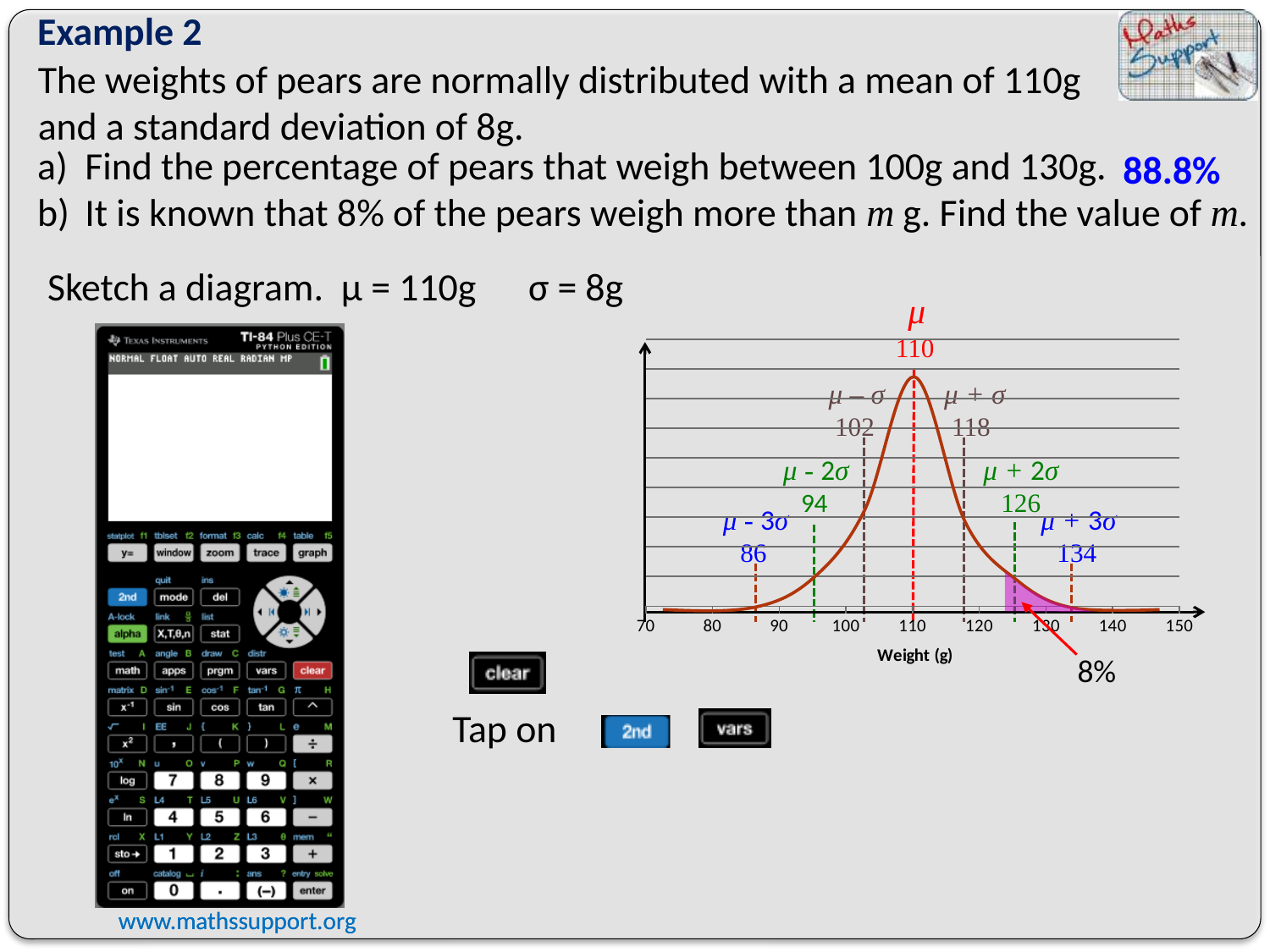
What value is marked at μ + σ on the chart? 118 What percentage is labelled for the shaded region in the right tail of the curve? 8% What value is marked at μ + 3σ on the chart? 134 What is the difference between the values marked at μ + σ and μ − σ? 16 What value is marked at μ on the chart? 110 What is the label on the horizontal axis of the chart? Weight (g) What value is marked at μ − σ on the chart? 102 What value is marked at μ − 3σ on the chart? 86 What value is marked at μ + 2σ on the chart? 126 What value is marked at μ − 2σ on the chart? 94 What kind of chart is shown on the slide? A line chart (normal distribution curve) At which weight value does the curve reach its peak? 110